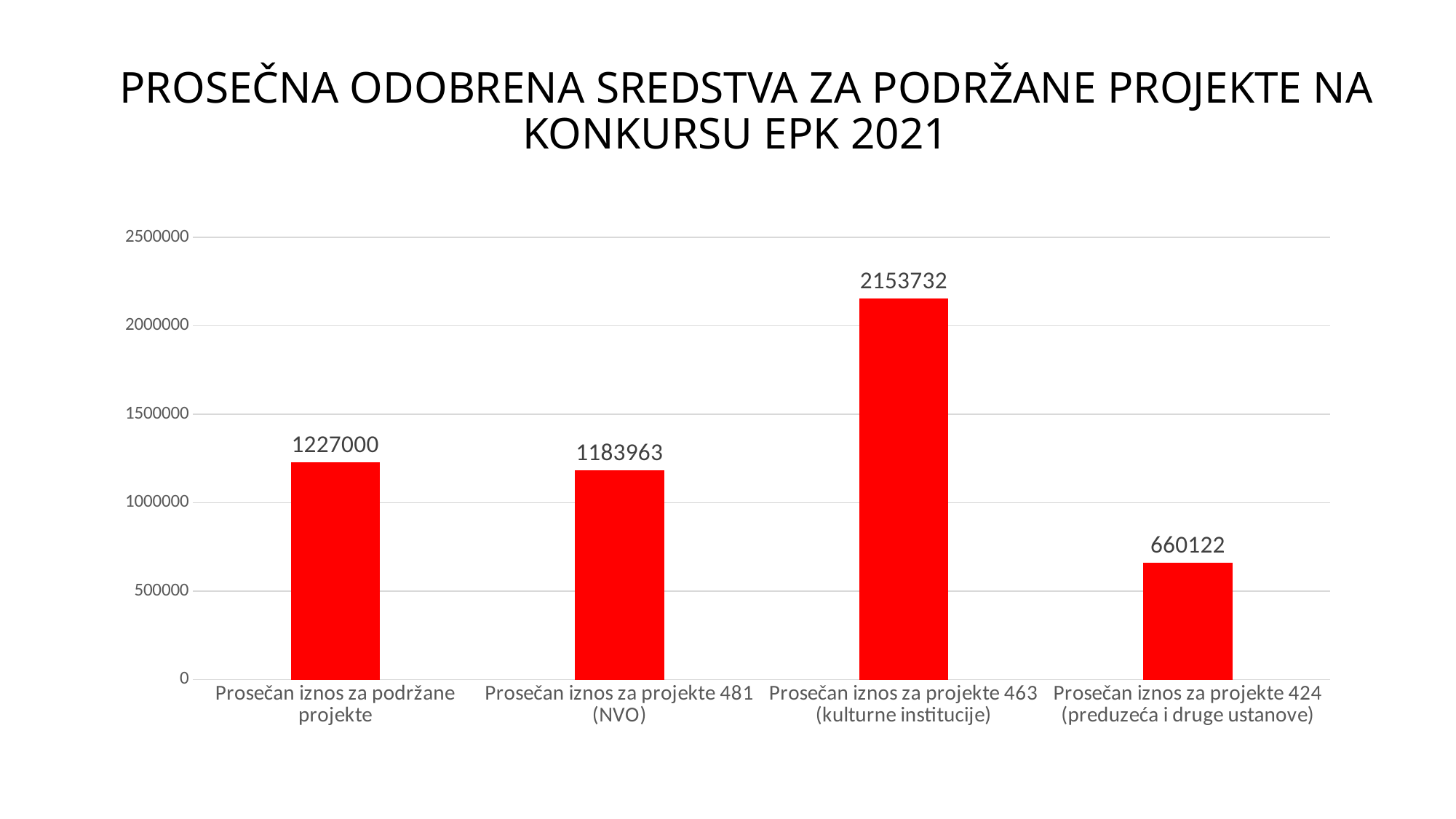
What is the difference between the values for 'Prosečan iznos za podržane projekte' and 'Prosečan iznos za projekte 481 (NVO)'? 43037 Which category has the lowest value? Prosečan iznos za projekte 424 (preduzeća i druge ustanove) What is the value for 'Prosečan iznos za projekte 424 (preduzeća i druge ustanove)'? 660122 What is the value for 'Prosečan iznos za projekte 481 (NVO)'? 1183963 Is the value for 'Prosečan iznos za projekte 463 (kulturne institucije)' greater or less than 2000000? greater What is the value for 'Prosečan iznos za projekte 463 (kulturne institucije)'? 2153732 Which category has the highest value? Prosečan iznos za projekte 463 (kulturne institucije) Which is larger: the value for 'Prosečan iznos za projekte 481 (NVO)' or for 'Prosečan iznos za projekte 424 (preduzeća i druge ustanove)'? Prosečan iznos za projekte 481 (NVO) What is the value for 'Prosečan iznos za podržane projekte'? 1227000 What kind of chart is shown on the slide? bar chart How many categories are shown in the chart? 4 What is the difference between the values for 'Prosečan iznos za projekte 463 (kulturne institucije)' and 'Prosečan iznos za projekte 424 (preduzeća i druge ustanove)'? 1493610